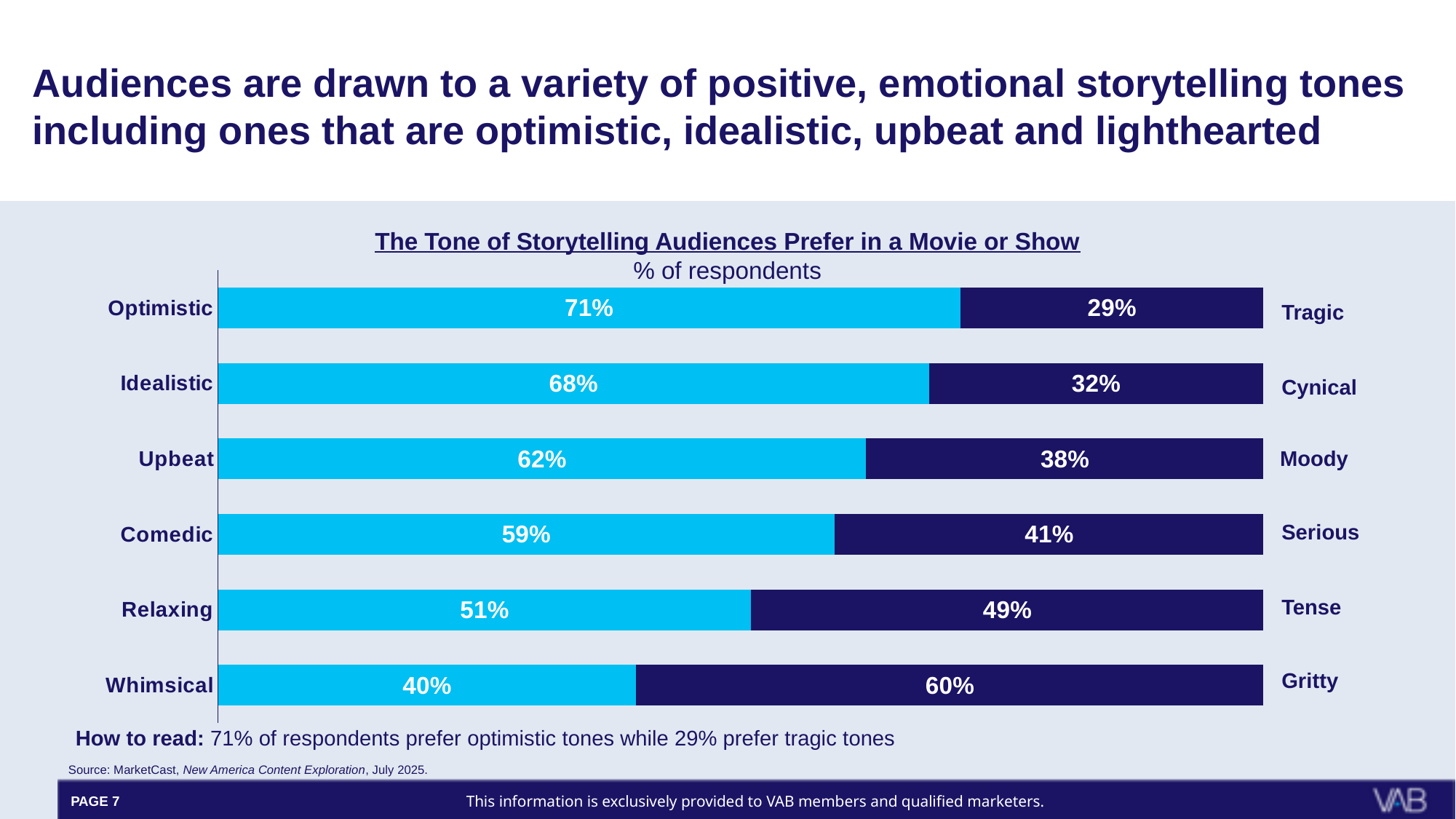
What percentage of respondents prefer gritty tones over whimsical tones? 60% Which has a larger share of respondents, tense or tragic? Tense Which positive tone on the left side of the chart has the highest share of respondents? Optimistic What is the total of the relaxing and tense shares in the Relaxing bar? 100% Which has a larger share of respondents, comedic or serious? Comedic What kind of chart is shown on the slide? Stacked bar chart Which positive tone on the left side of the chart has the lowest share of respondents? Whimsical What percentage of respondents prefer moody tones? 38% How many pairs of tones are shown in the chart? 6 What is the difference between the share preferring idealistic tones and the share preferring cynical tones? 36% What is the title of the chart? The Tone of Storytelling Audiences Prefer in a Movie or Show What percentage of respondents prefer optimistic tones? 71%